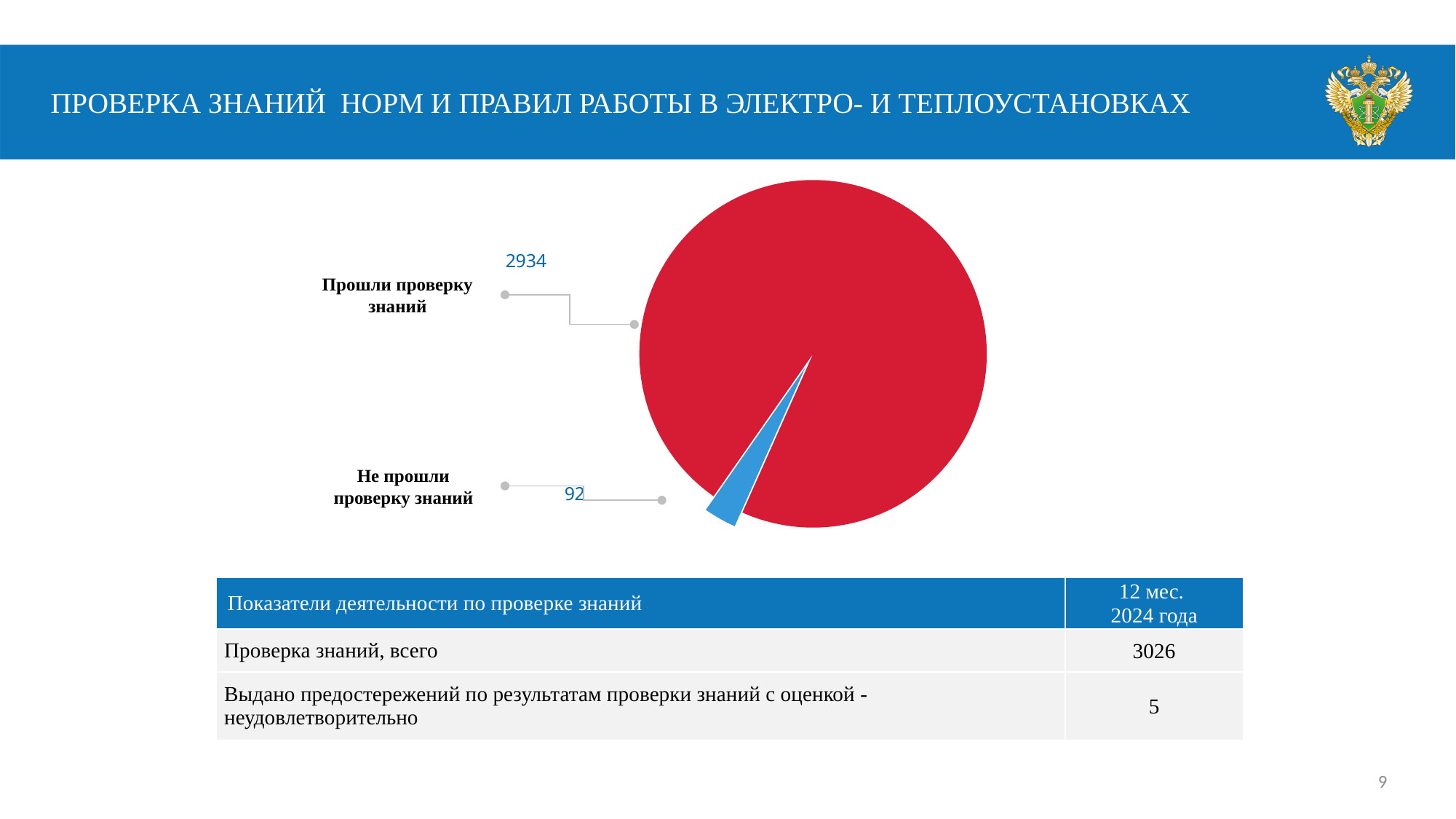
How many categories are shown in the pie chart? 2 Which category has the smallest slice in the pie chart? Не прошли проверку знаний What is the difference between the number who passed and the number who did not pass the knowledge check? 2842 What type of chart is shown on the slide? Pie chart What colour is the slice for Прошли проверку знаний? Red How many people passed the knowledge check (Прошли проверку знаний) according to the pie chart? 2934 Which category has the largest slice in the pie chart? Прошли проверку знаний What is the total of the two values shown in the pie chart? 3026 Which is larger: the number who passed the knowledge check or the number who did not pass? Прошли проверку знаний What colour is the slice for Не прошли проверку знаний? Blue How many people did not pass the knowledge check (Не прошли проверку знаний) according to the pie chart? 92